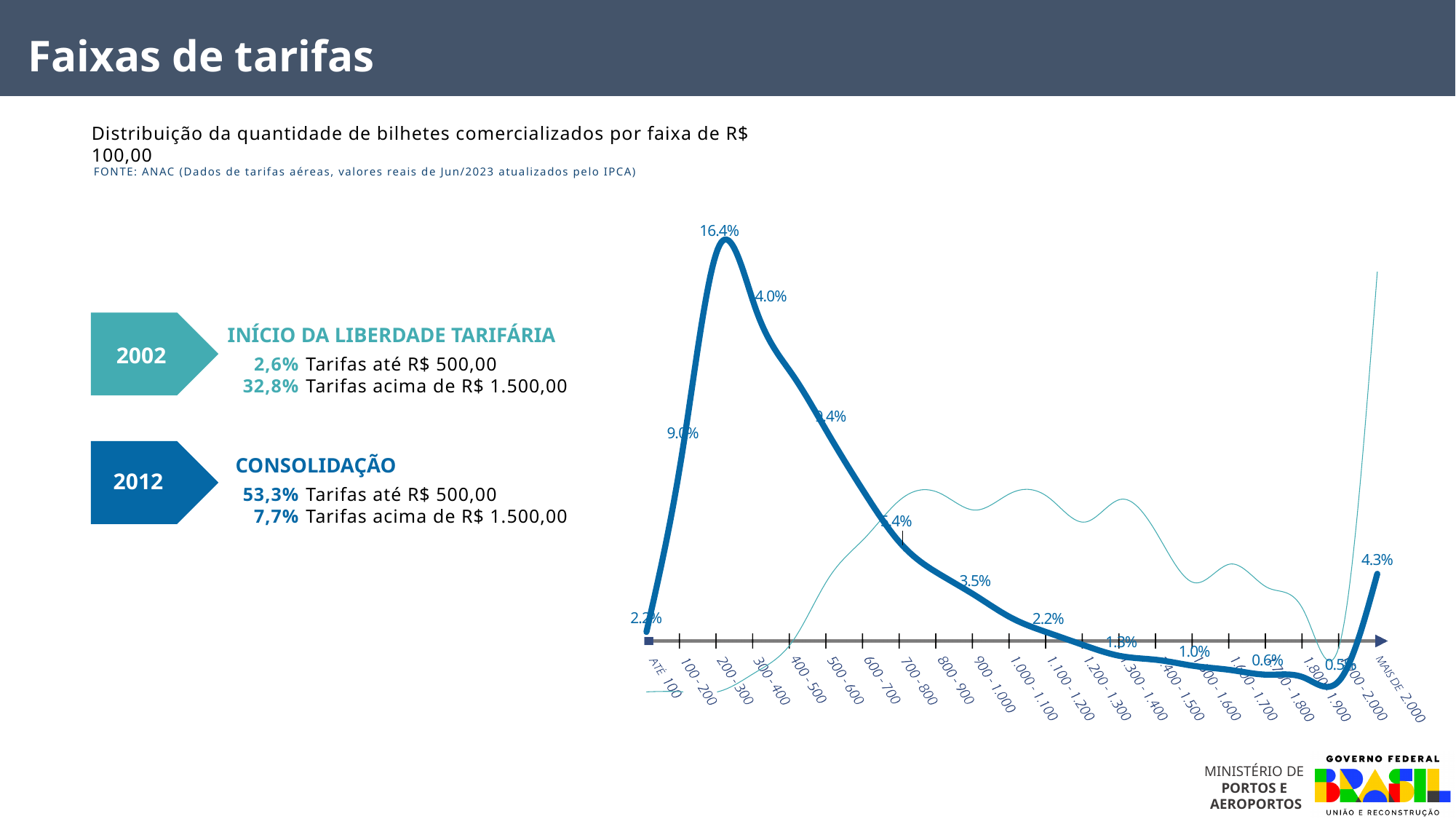
Which fare range has the highest value on the thick dark blue line? 200 - 300 What kind of chart is shown on the slide? line chart What is the value of the thick dark blue line for the 300 - 400 fare range? 14.0% How many lines are plotted on the chart? 2 What is the value of the thick dark blue line for the 100 - 200 fare range? 9.0% On the thick dark blue line, which is larger: the value for 100 - 200 or the value for 300 - 400? 300 - 400 Does the thick dark blue line rise or fall between the 200 - 300 range and the 1.900 - 2.000 range? fall What is the value of the thick dark blue line for the 200 - 300 fare range? 16.4% How many fare range categories are shown on the x axis? 21 On the thick dark blue line, what is the difference between the 200 - 300 value and the 300 - 400 value? 2.4 percentage points What is the value of the thick dark blue line for the 'ATÉ 100' fare range? 2.2% What is the value of the thick dark blue line for the 'MAIS DE 2.000' fare range? 4.3%